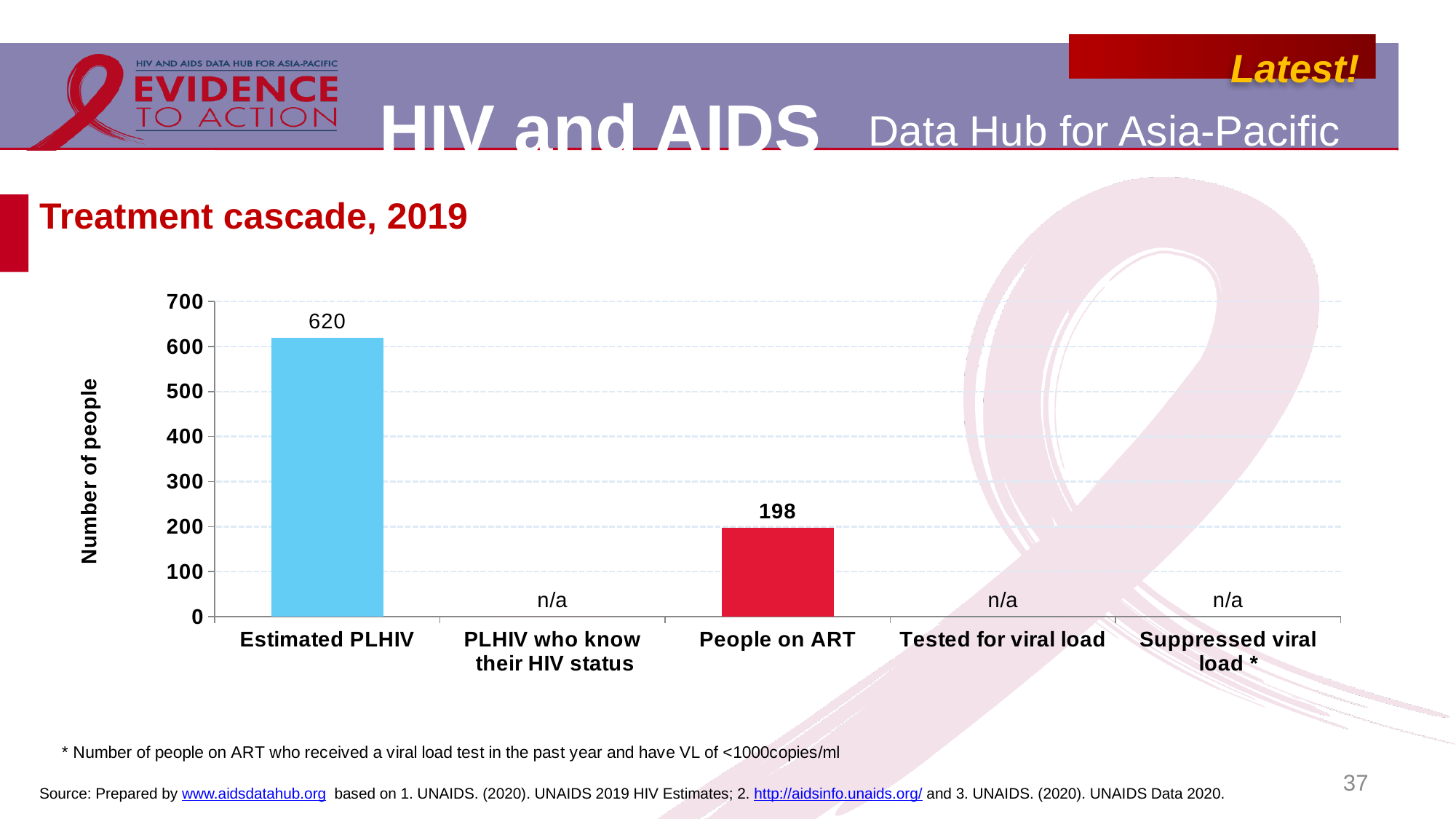
What is shown for Tested for viral load? n/a Which is larger, Estimated PLHIV or People on ART? Estimated PLHIV Which category has the highest value? Estimated PLHIV What kind of chart is this? bar chart What is the value for People on ART? 198 How many categories are shown on the x axis? 5 What is the value for Estimated PLHIV? 620 What is the difference between Estimated PLHIV and People on ART? 422 Is the value for People on ART greater or less than 200? less What is shown for PLHIV who know their HIV status? n/a Is the value for Estimated PLHIV greater or less than 600? greater What is the label of the y axis? Number of people